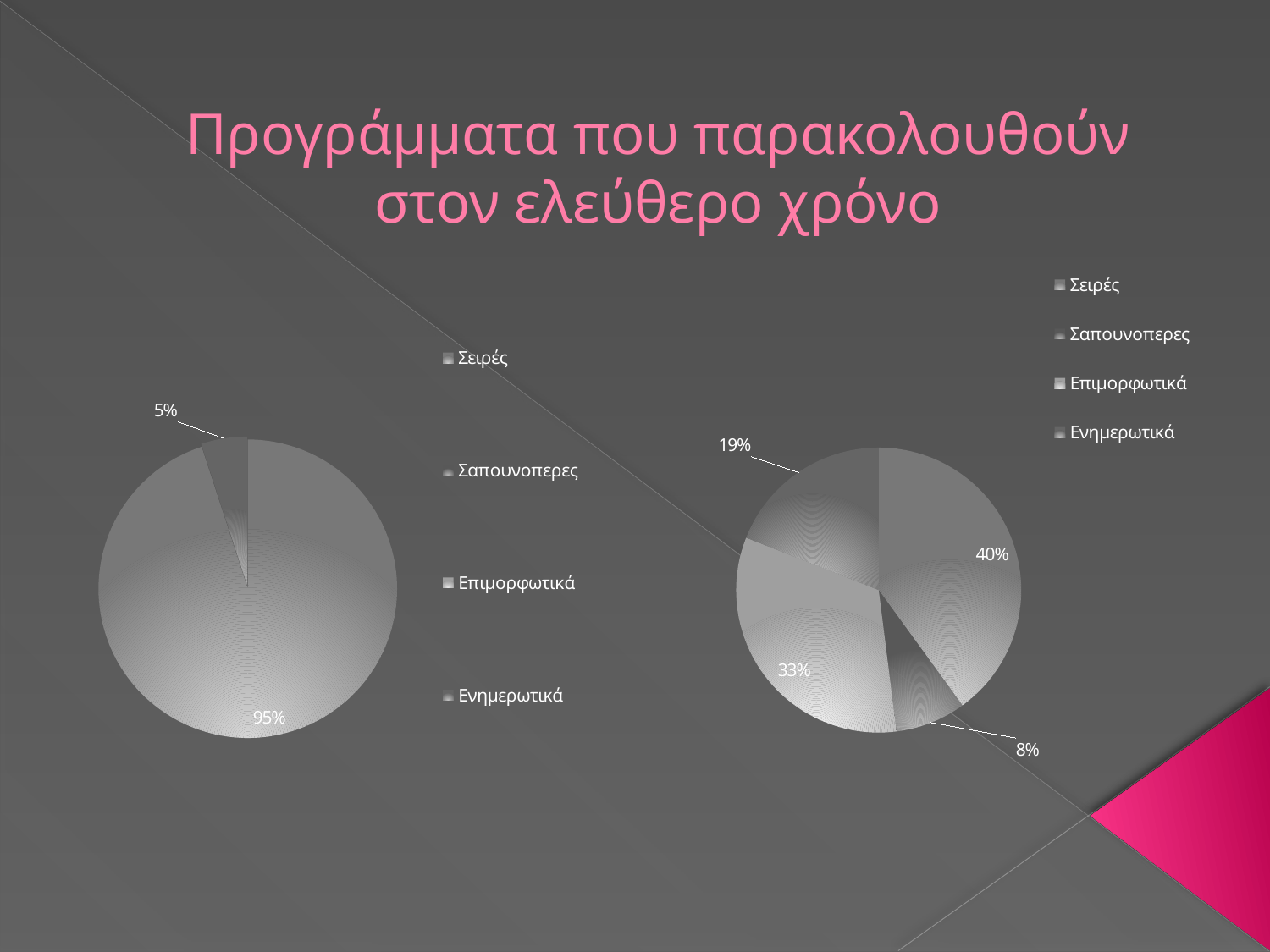
In the left pie chart, what is the difference between the two labelled slices? 90 percentage points How many labelled slices does the left pie chart have? 2 In the left pie chart, what is the value of the largest slice? 95% In the right pie chart, what is the difference between the 40% slice and the 33% slice? 7 percentage points How many pie charts are shown on the slide? 2 In the right pie chart, what is the value of the largest slice? 40% In the right pie chart, what is the value of the smallest slice? 8% How many labelled slices does the right pie chart have? 4 What is the title of the slide? Προγράμματα που παρακολουθούν στον ελεύθερο χρόνο How many entries does the legend of the right pie chart list? 4 What kind of chart is used on the left side of the slide? Pie chart In the left pie chart, what is the value of the smallest slice? 5%